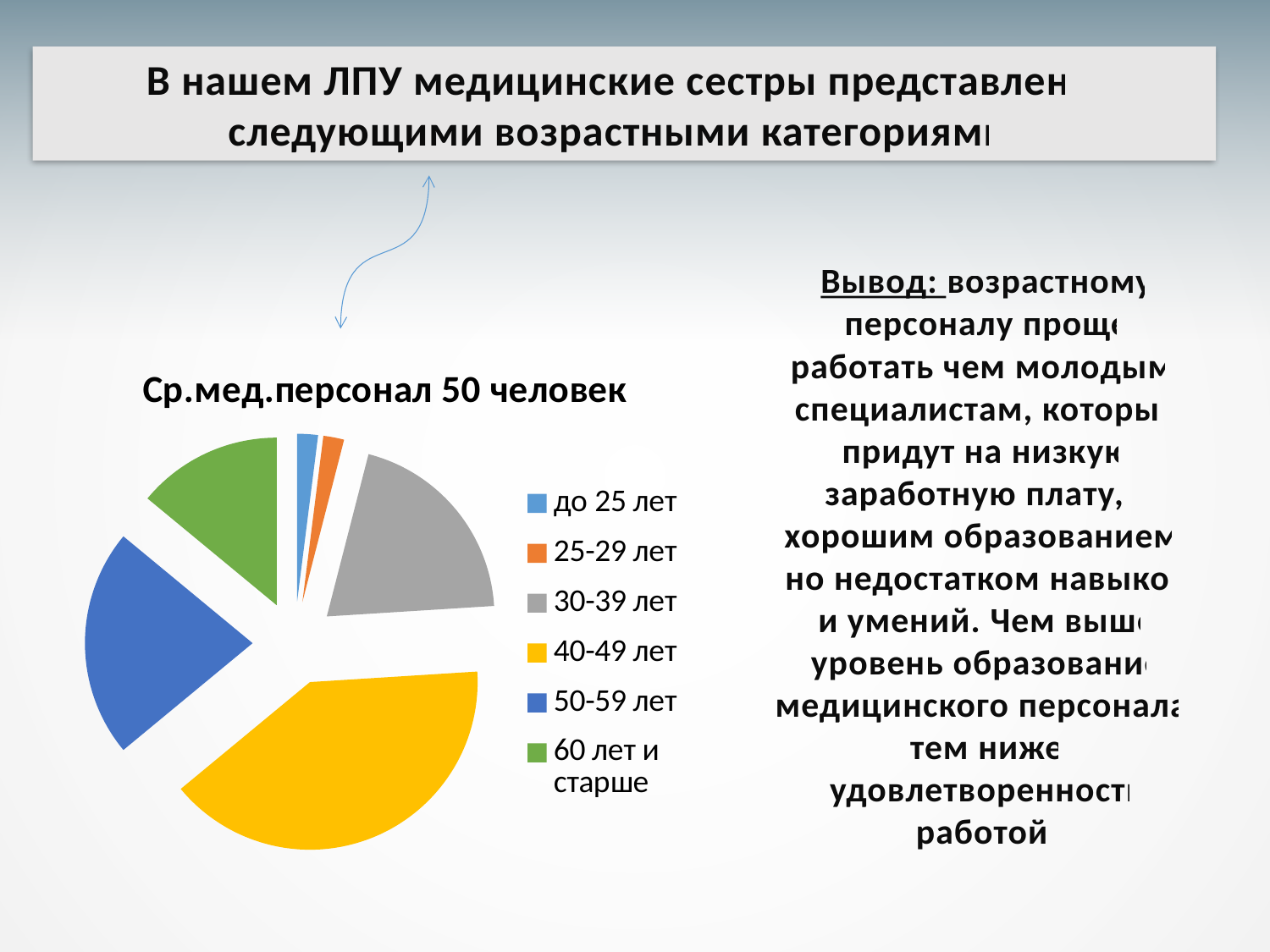
How many age categories does the pie chart show? 6 Which slice is larger in the pie chart: 40-49 лет or 30-39 лет? 40-49 лет Which slice is larger in the pie chart: 30-39 лет or 25-29 лет? 30-39 лет Which age category has the largest slice in the pie chart? 40-49 лет What is the title of the pie chart? Ср.мед.персонал 50 человек Which slice is larger in the pie chart: 50-59 лет or 60 лет и старше? 50-59 лет What colour is the slice for 40-49 лет in the pie chart? yellow How many entries does the legend of the pie chart list? 6 What kind of chart is shown on the slide? pie chart